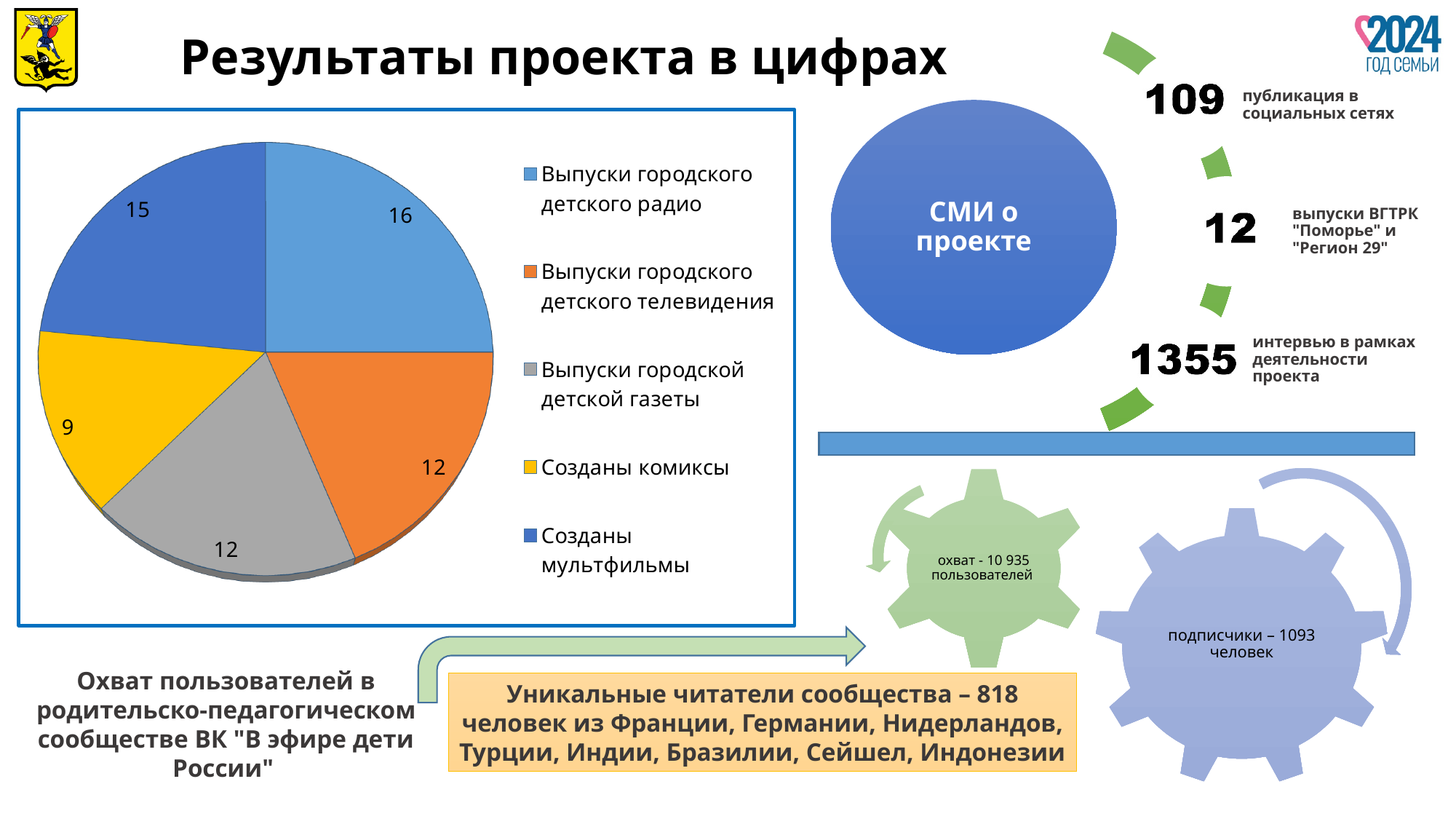
Какую долю круговой диаграммы занимает категория «Выпуски городского детского радио»? 25% Какая категория на круговой диаграмме имеет наибольшее значение? Выпуски городского детского радио Сколько категорий показано на круговой диаграмме? 5 Какое значение на круговой диаграмме у категории «Созданы мультфильмы»? 15 Какого типа диаграмма показана на слайде? Круговая диаграмма Какое значение на круговой диаграмме у категории «Выпуски городского детского радио»? 16 Какая категория на круговой диаграмме имеет наименьшее значение? Созданы комиксы На сколько значение «Выпуски городского детского радио» больше значения «Созданы комиксы»? 7 Какова сумма всех значений на круговой диаграмме? 64 Какое значение на круговой диаграмме у категории «Выпуски городской детской газеты»? 12 Какое значение на круговой диаграмме у категории «Созданы комиксы»? 9 Что больше: «Созданы мультфильмы» или «Выпуски городского детского телевидения»? Созданы мультфильмы